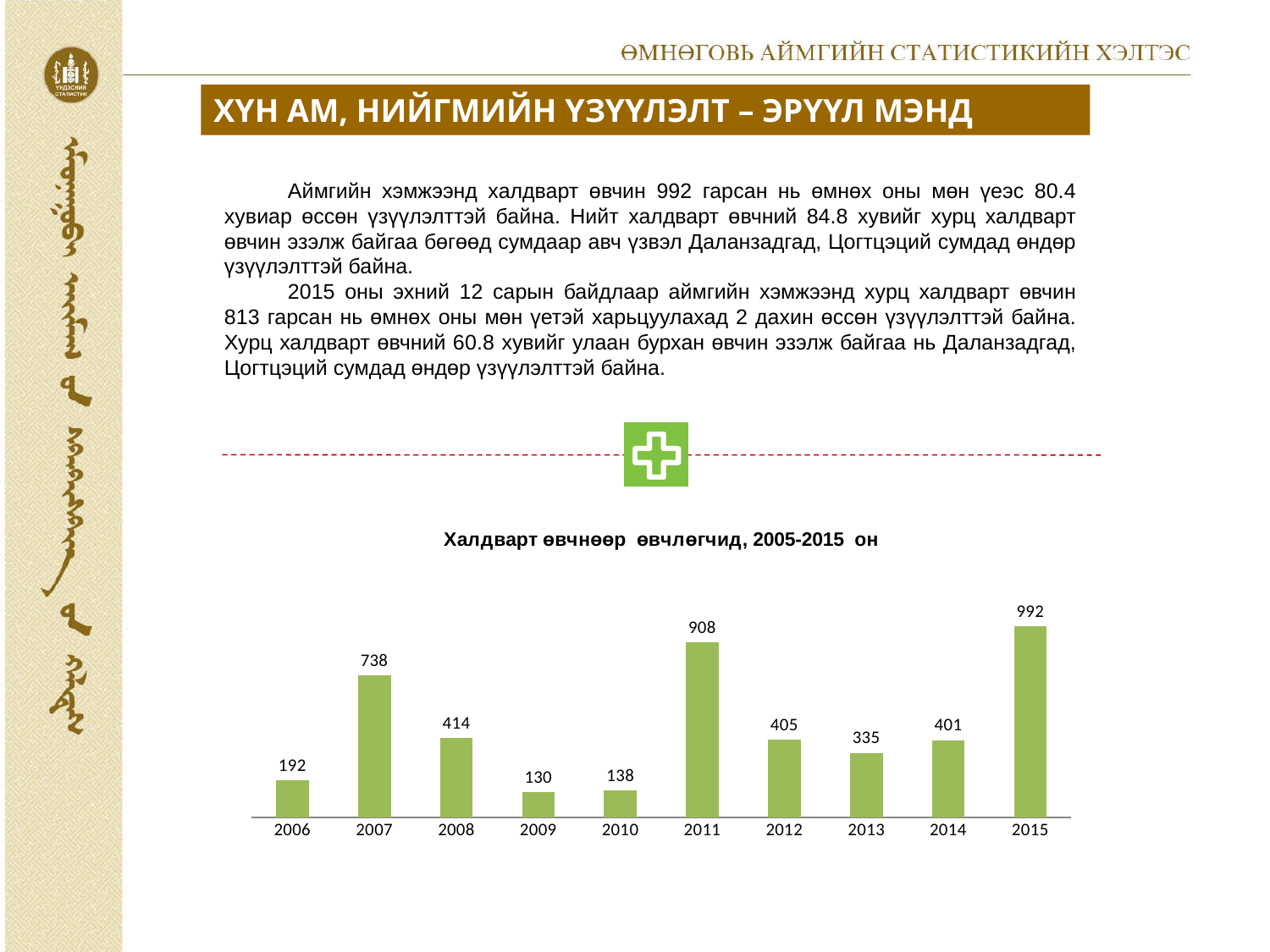
What is the value for 2006? 192 Which is larger, the value for 2012 or the value for 2013? 2012 What kind of chart is this? bar chart How many years are shown on the x axis? 10 What is the title of the chart? Халдварт өвчнөөр өвчлөгчид, 2005-2015 он What is the difference between the values for 2007 and 2008? 324 What is the difference between the values for 2015 and 2014? 591 Do the values rise or fall from 2013 to 2015? rise What is the value for 2011? 908 Which year has the highest value? 2015 Which year has the lowest value? 2009 What is the value for 2013? 335